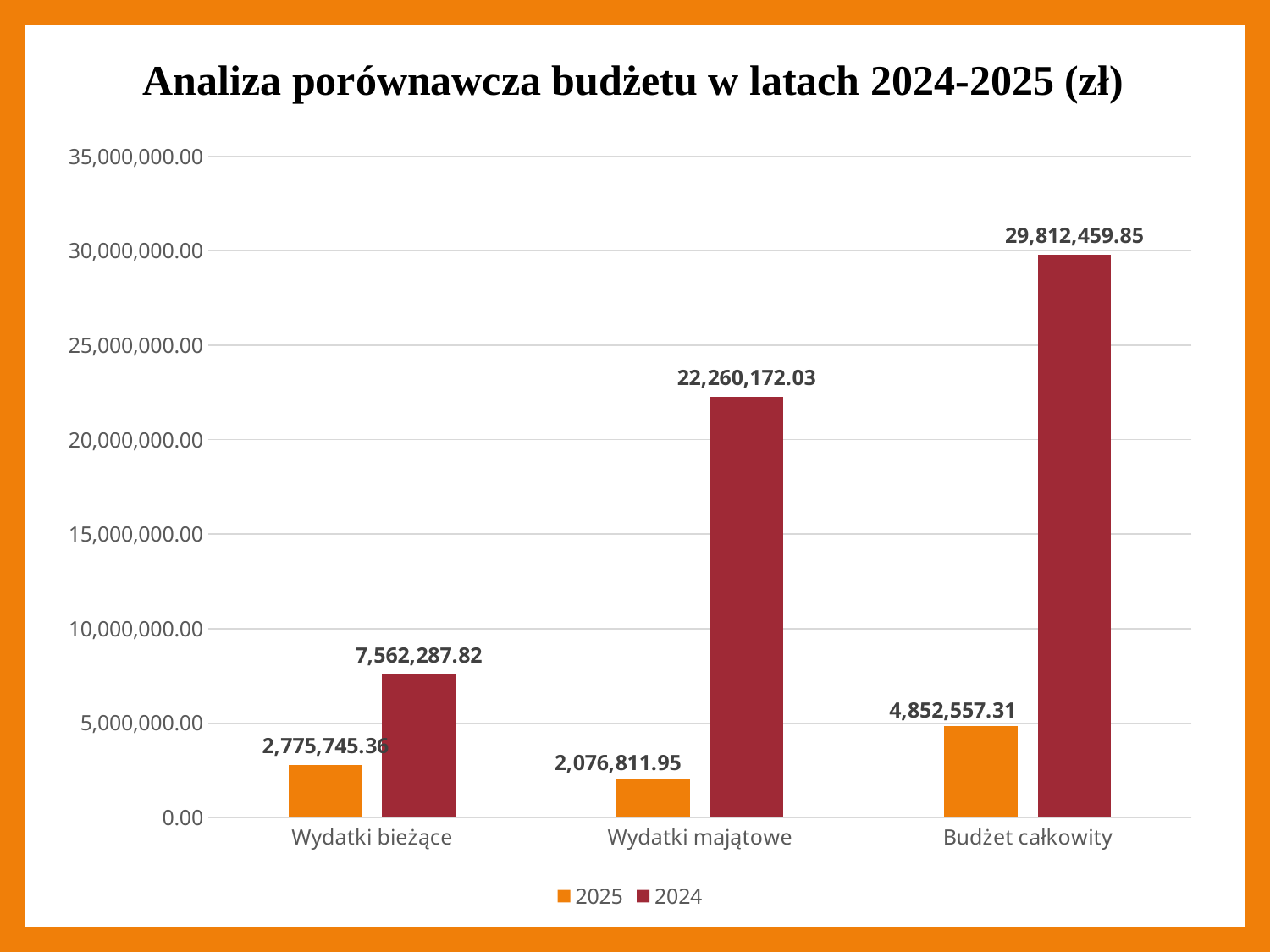
How many series does the legend list? 2 What is the difference between the 2024 and 2025 values for Wydatki bieżące? 4,786,542.46 What kind of chart is shown on the slide? bar chart Which category has the lowest value in the 2025 series? Wydatki majątowe How many categories are shown on the x axis? 3 Which category has the highest value in the 2024 series? Budżet całkowity What is the value for Wydatki majątowe in the 2024 series? 22,260,172.03 Which is larger for Wydatki majątowe: the 2025 value or the 2024 value? 2024 What is the value for Wydatki bieżące in the 2025 series? 2,775,745.36 What is the value for Budżet całkowity in the 2025 series? 4,852,557.31 What is the difference between the 2024 and 2025 values for Budżet całkowity? 24,959,902.54 Is the 2024 value for Wydatki bieżące greater or less than 10,000,000.00? less